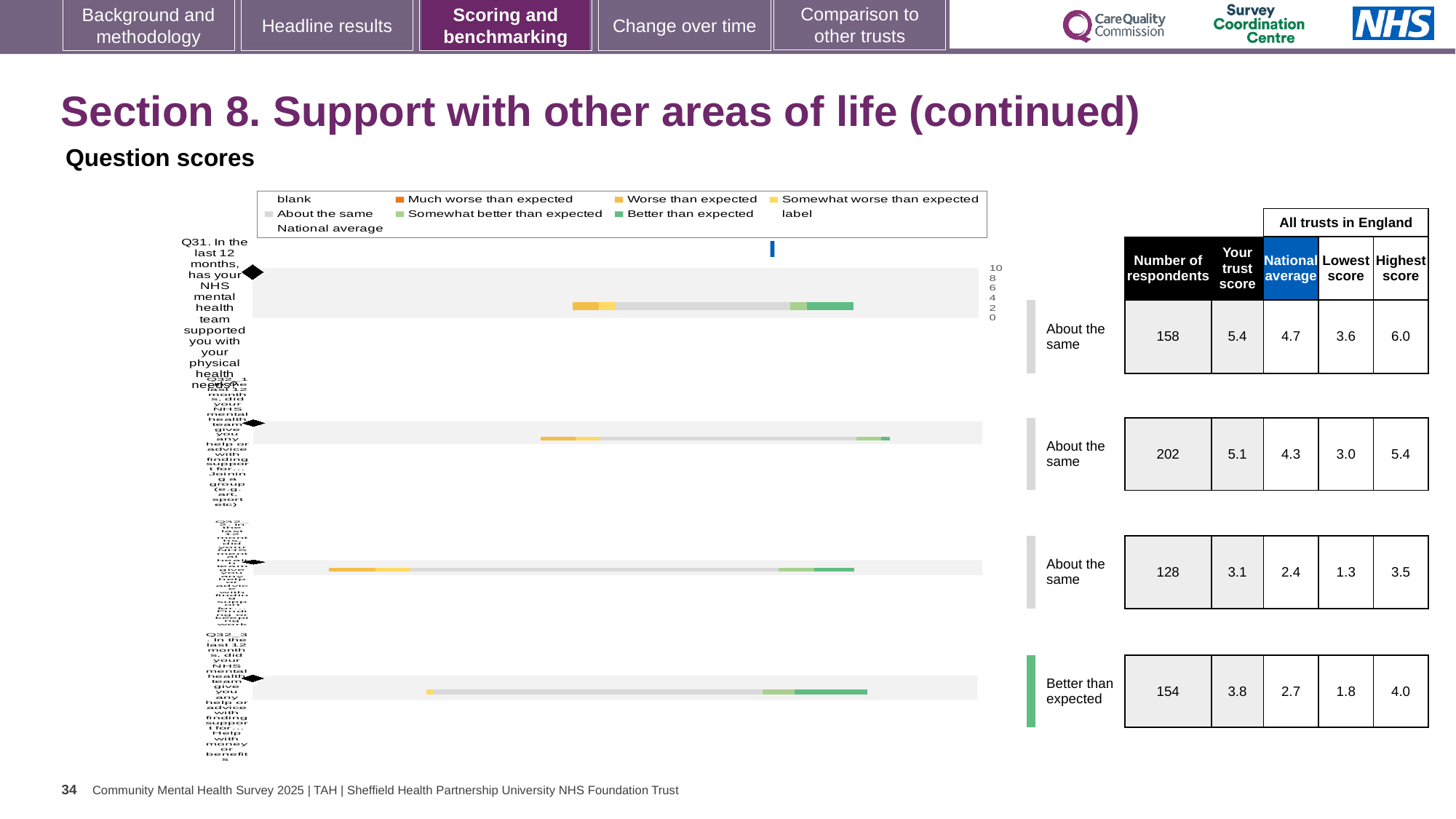
What is the 'Your trust score' for Q31 (the first row)? 5.4 Which row has the highest 'Your trust score'? Q31 (the first row), 5.4 What is the highest score for the second row? 5.4 What benchmark category is shown for the fourth row? Better than expected For the fourth row, which is larger: the trust score or the national average? the trust score (3.8) What is the national average for Q31 (the first row)? 4.7 What kind of chart is shown on the slide? bar chart How many questions (bars) are plotted in the chart? 4 How many rows are rated 'About the same'? 3 Which row has the lowest 'Lowest score' value? the third row, 1.3 What is the number of respondents for Q31 (the first row)? 158 What is the difference between the trust score and the national average for Q31 (the first row)? 0.7